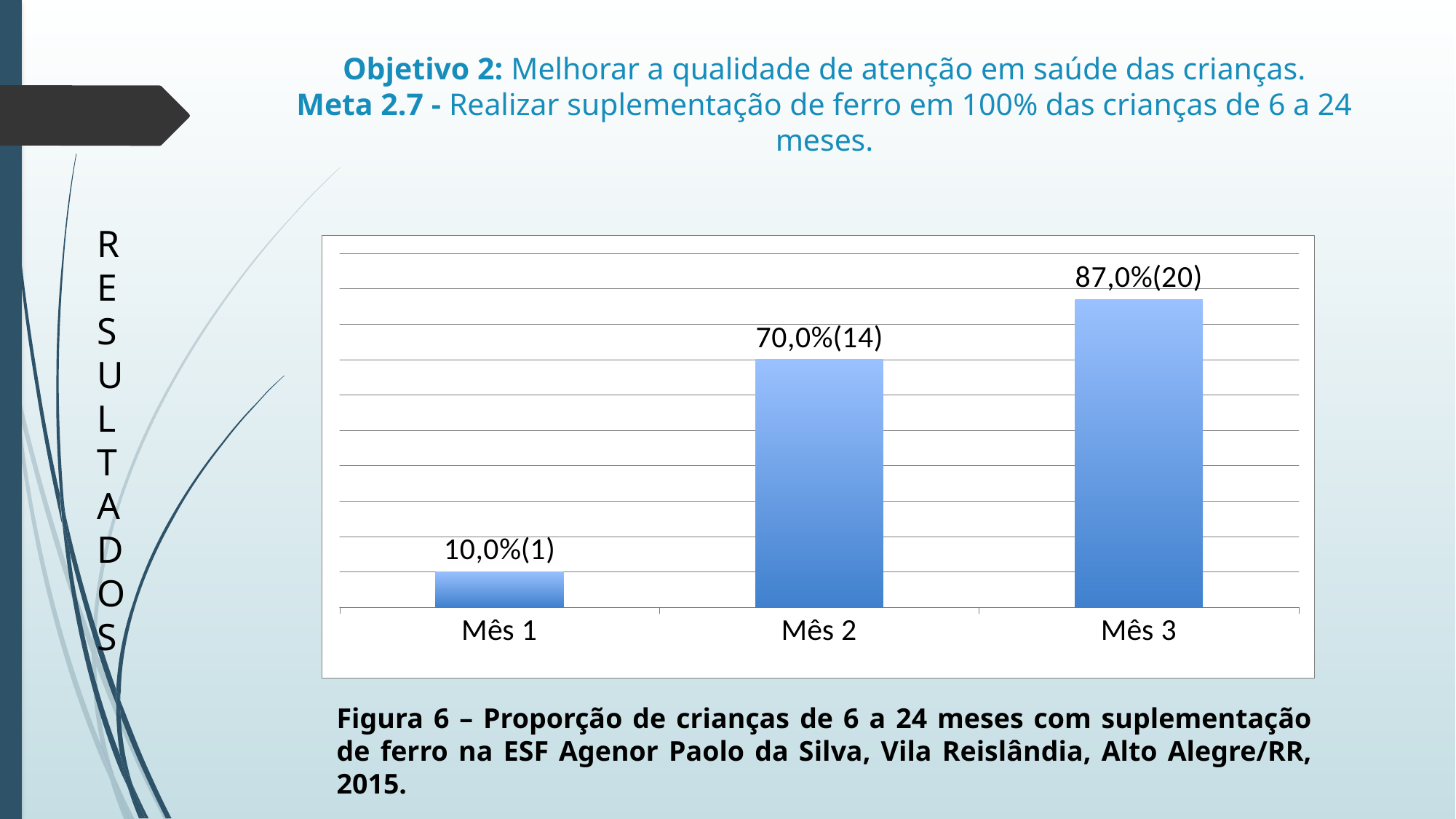
Do the values rise or fall from Mês 1 to Mês 3? Rise Which is larger, the value for Mês 1 or the value for Mês 2? Mês 2 What is the difference in percentage points between Mês 2 and Mês 1? 60,0% What is the data label shown for Mês 2? 70,0%(14) Which month has the highest proportion? Mês 3 What is the data label shown for Mês 1? 10,0%(1) Which month has the lowest proportion? Mês 1 How many children are counted in parentheses for Mês 3? 20 How many months (categories) are shown on the x axis? 3 What is the data label shown for Mês 3? 87,0%(20) What kind of chart is shown on the slide? Bar chart What is the difference in percentage points between Mês 3 and Mês 2? 17,0%